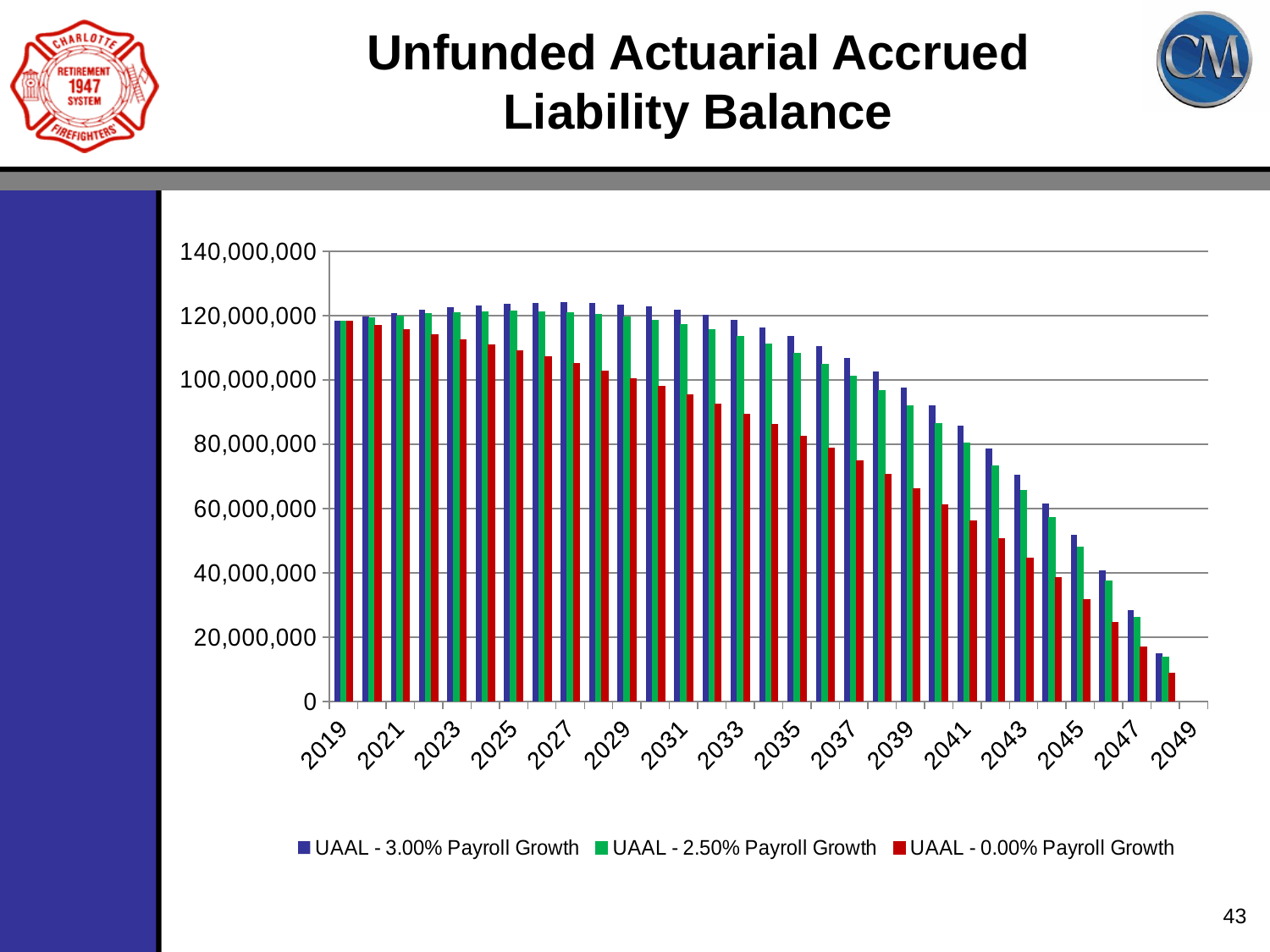
In 2039, which is larger: UAAL - 3.00% Payroll Growth or UAAL - 0.00% Payroll Growth? UAAL - 3.00% Payroll Growth Is the value for UAAL - 3.00% Payroll Growth in 2045 greater or less than 60,000,000? less How many years are plotted along the x axis, from 2019 to 2049? 31 How many series does the legend list? 3 In which year is the UAAL - 3.00% Payroll Growth series lowest? 2049 In which year is the UAAL - 0.00% Payroll Growth series highest? 2019 Which colour represents the UAAL - 2.50% Payroll Growth series? green Does the UAAL - 0.00% Payroll Growth series rise or fall from 2019 to 2049? fall Is the value for UAAL - 0.00% Payroll Growth in 2037 greater or less than 80,000,000? less Is the value for UAAL - 3.00% Payroll Growth in 2027 greater or less than 120,000,000? greater What kind of chart is shown on the slide? bar chart